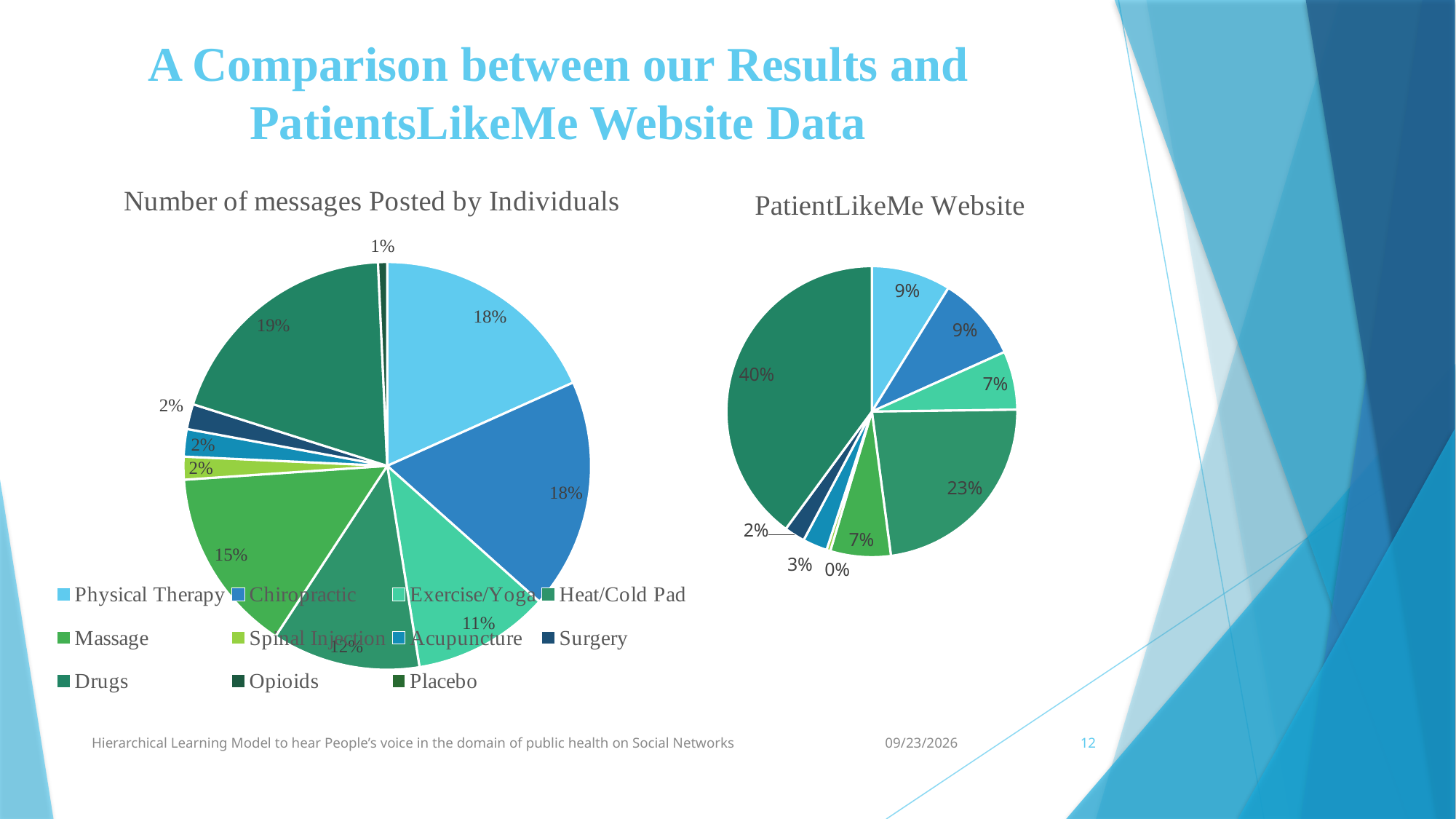
In the 'PatientLikeMe Website' pie chart, what share does Heat/Cold Pad have? 23% In the 'Number of messages Posted by Individuals' pie chart, what percentage is shown for Drugs? 19% Is the Physical Therapy share larger in the 'Number of messages Posted by Individuals' chart or in the 'PatientLikeMe Website' chart? Number of messages Posted by Individuals How many categories are listed in the legend on the slide? 11 What type of chart is used for the 'PatientLikeMe Website' data? Pie chart In the 'PatientLikeMe Website' pie chart, what percentage is shown for Physical Therapy? 9% In the 'PatientLikeMe Website' pie chart, which category has the largest slice? Drugs In the 'Number of messages Posted by Individuals' pie chart, which category has the largest slice? Drugs In the 'PatientLikeMe Website' pie chart, what percentage is shown for Drugs? 40% In the 'PatientLikeMe Website' pie chart, what is the difference in percentage points between Drugs and Heat/Cold Pad? 17 percentage points In the 'Number of messages Posted by Individuals' pie chart, what percentage is shown for Massage? 15% In the 'Number of messages Posted by Individuals' pie chart, what percentage is shown for Exercise/Yoga? 11%